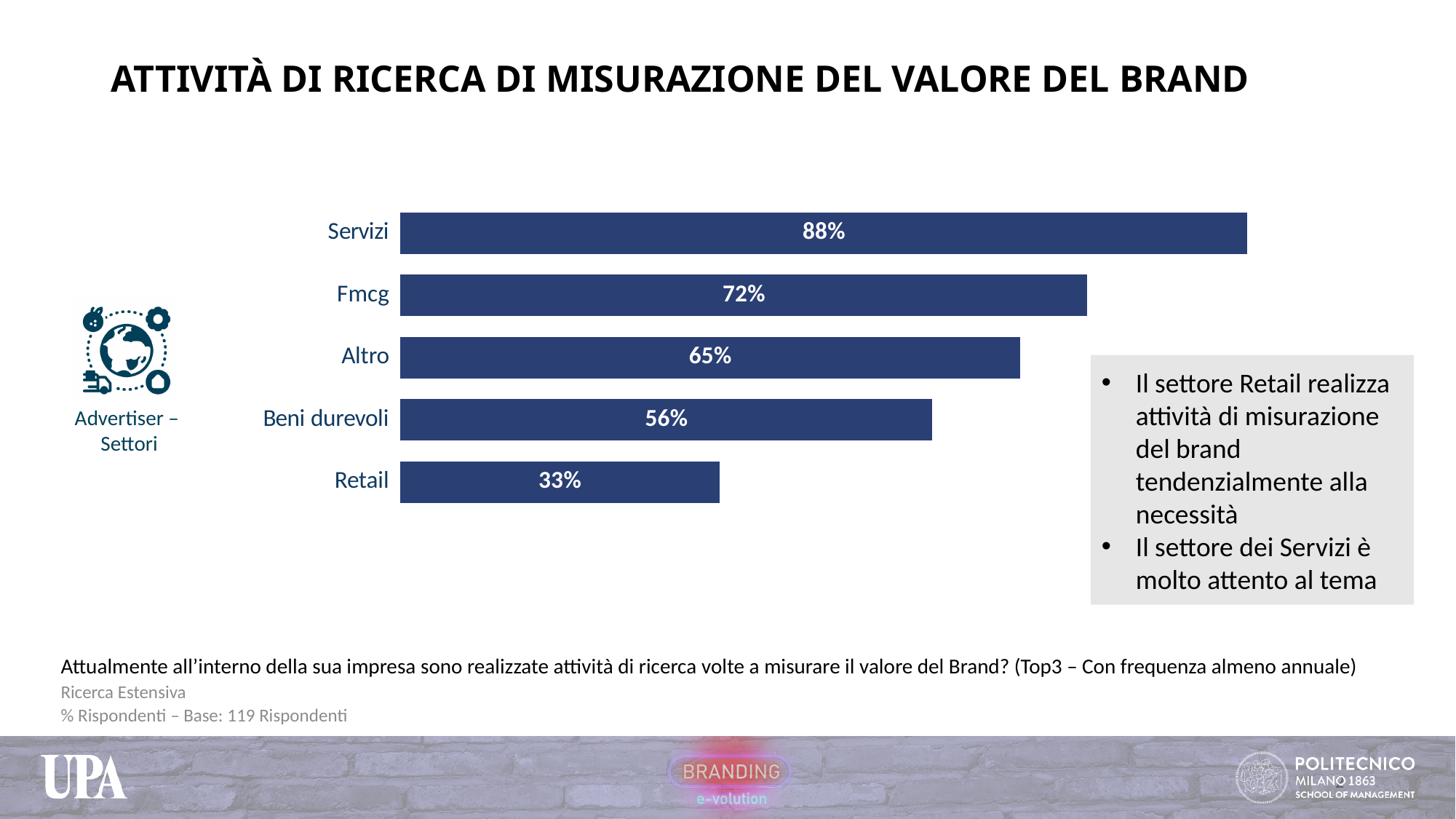
What is the difference between the values for Fmcg and Altro? 7% What is the difference between the values for Servizi and Retail? 55% Which sector has the highest value? Servizi Which is larger, the value for Altro or the value for Beni durevoli? Altro Which sector has the lowest value? Retail What is the value for Servizi? 88% What is the value for Fmcg? 72% What is the value for Retail? 33% What is the value for Beni durevoli? 56% What kind of chart is shown on the slide? Bar chart What is the title of the slide containing the chart? ATTIVITÀ DI RICERCA DI MISURAZIONE DEL VALORE DEL BRAND How many sectors are shown in the chart? 5